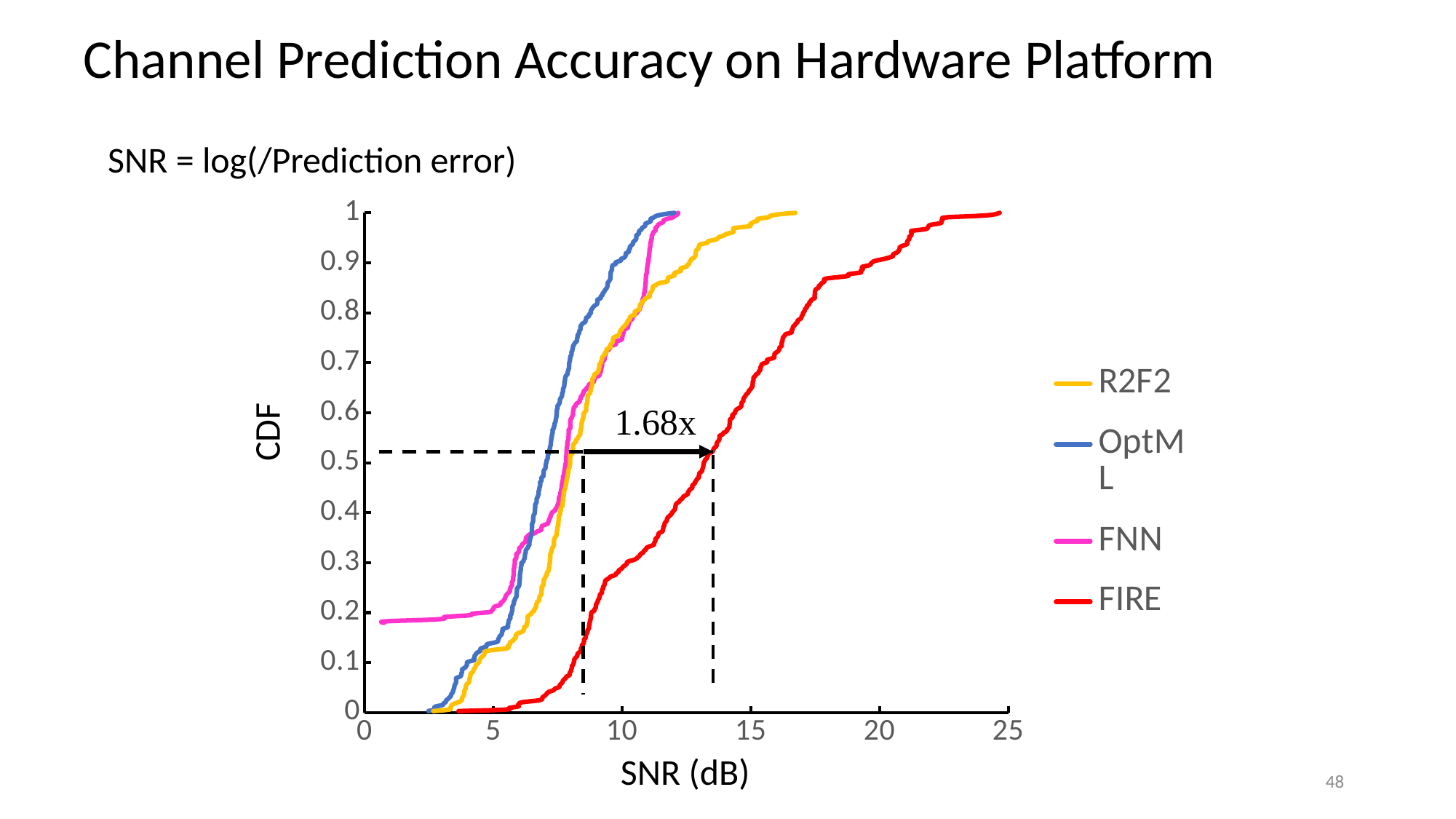
What is the label of the x axis? SNR (dB) Is the SNR at which the FIRE curve reaches a CDF of 0.9 greater or less than 15 dB? greater Is the maximum SNR reached by the OptML curve greater or less than 15 dB? less Which series reaches the highest SNR values on the chart? FIRE Do the CDF curves rise or fall as SNR increases along the x axis? rise What improvement factor is annotated on the chart with the arrow? 1.68x At a CDF of 0.5, which series has the larger SNR, FIRE or OptML? FIRE Which series has a CDF already above 0.1 at an SNR of 1 dB? FNN How many series does the legend list? 4 What are the four series named in the legend? R2F2, OptML, FNN, FIRE What kind of chart is shown on the slide? line chart Is the maximum SNR reached by the FIRE curve greater or less than 20 dB? greater